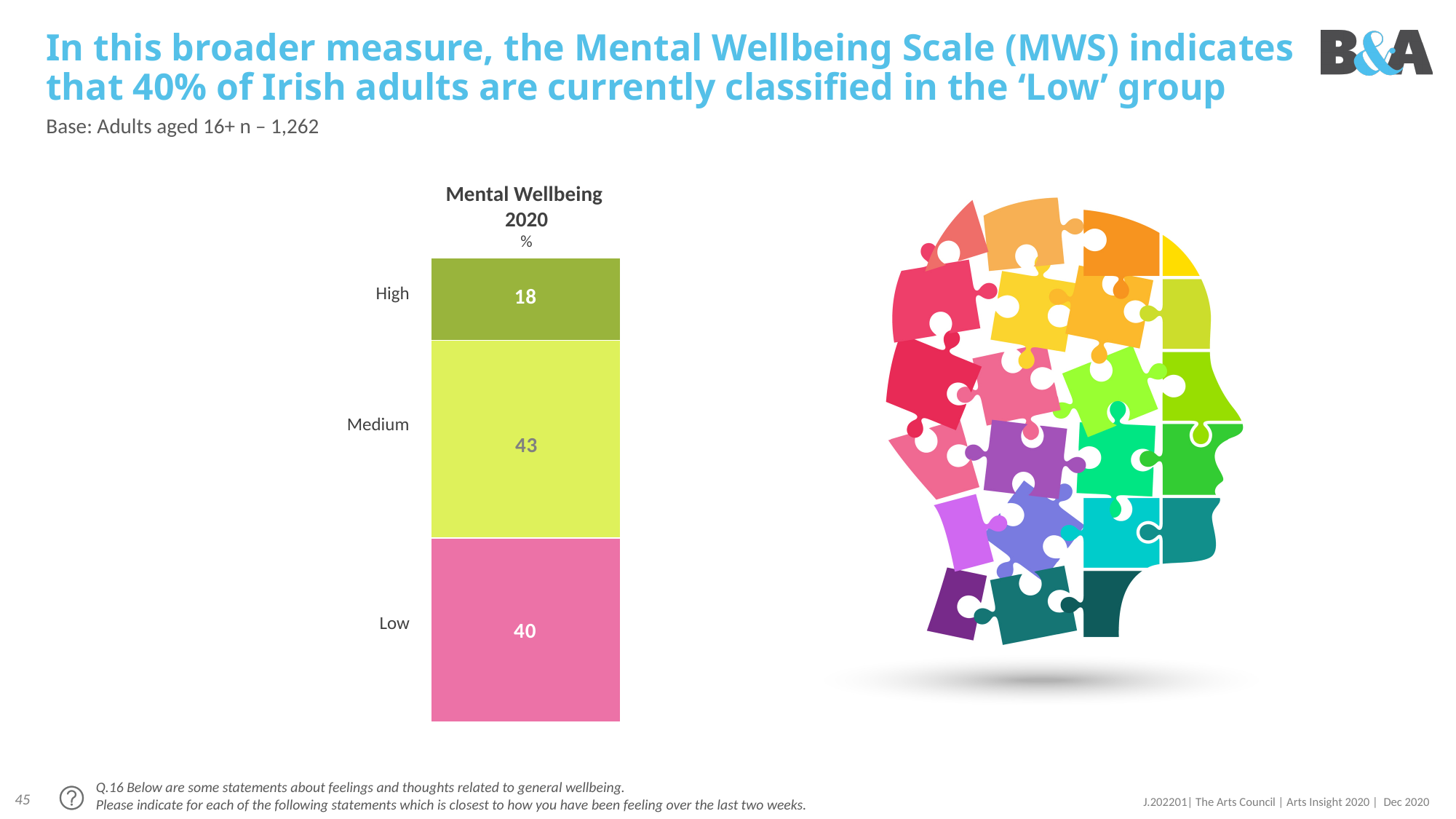
What percentage of Irish adults are classified in the 'High' mental wellbeing group? 18 What is the title of the chart? Mental Wellbeing 2020 How many mental wellbeing groups are shown in the stacked bar? 3 Which group is larger, Low or High? Low What is the total of the three segments in the stacked bar? 101 What is the difference in percentage points between the Medium and High groups? 25 Which mental wellbeing group has the smallest share? High What is the difference in percentage points between the Low and High groups? 22 Which mental wellbeing group has the largest share? Medium What percentage of Irish adults are classified in the 'Medium' mental wellbeing group? 43 What percentage of Irish adults are classified in the 'Low' mental wellbeing group? 40 What type of chart is used to show the Mental Wellbeing 2020 data? Stacked bar chart